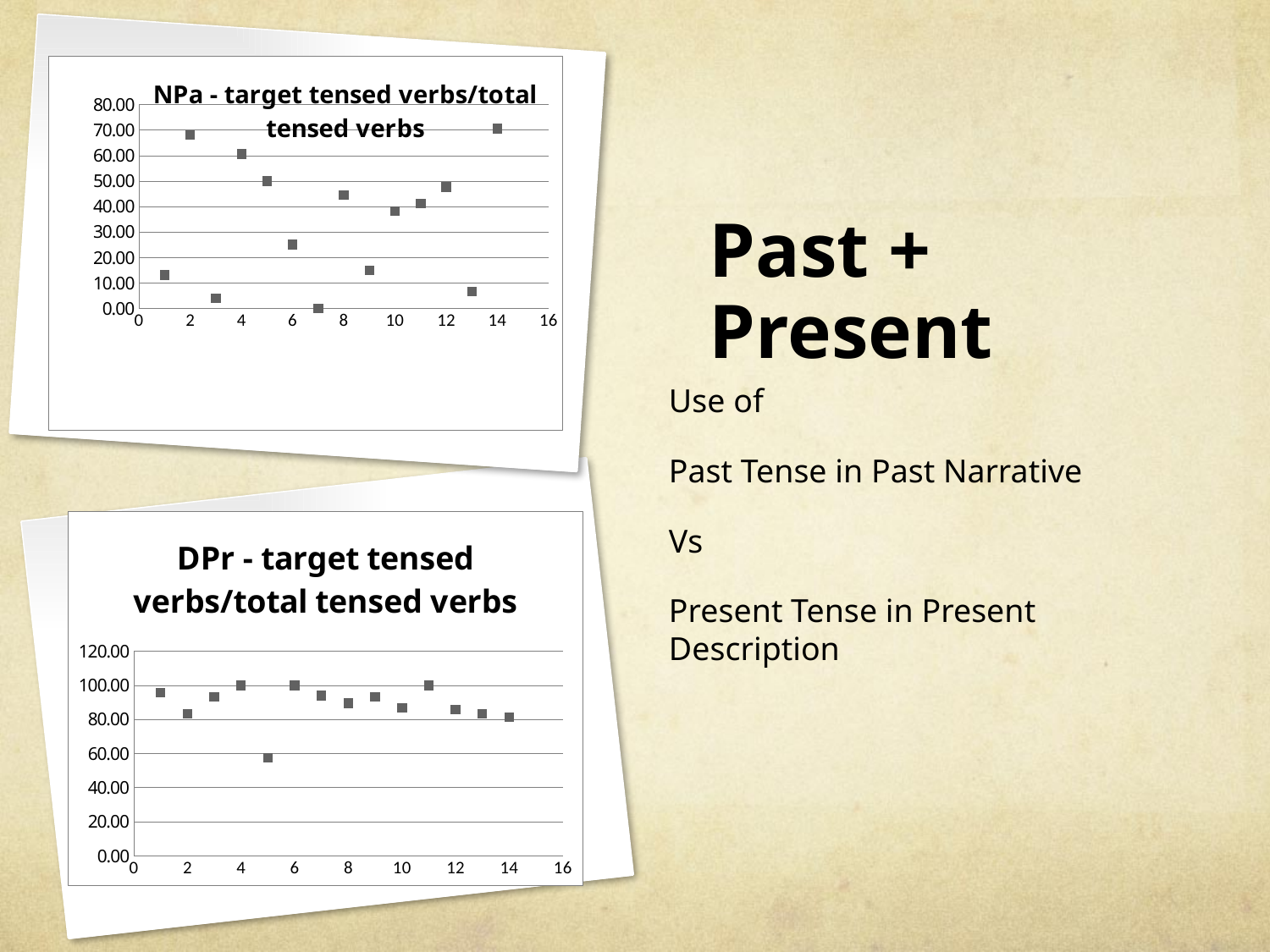
In the bottom chart 'DPr - target tensed verbs/total tensed verbs', is the value at x = 4 greater or less than 80.00? greater How many data points are plotted in the bottom chart 'DPr - target tensed verbs/total tensed verbs'? 14 In the top chart 'NPa - target tensed verbs/total tensed verbs', which has the larger value, the point at x = 2 or the point at x = 3? x = 2 In the top chart 'NPa - target tensed verbs/total tensed verbs', is the value at x = 6 greater or less than 20.00? greater How many data points are plotted in the top chart 'NPa - target tensed verbs/total tensed verbs'? 14 In the bottom chart 'DPr - target tensed verbs/total tensed verbs', which has the larger value, the point at x = 4 or the point at x = 5? x = 4 In the top chart 'NPa - target tensed verbs/total tensed verbs', is the value at x = 2 greater or less than 60.00? greater In the bottom chart 'DPr - target tensed verbs/total tensed verbs', at which x value is the lowest point? 5 What kind of chart is the top chart titled 'NPa - target tensed verbs/total tensed verbs'? scatter chart What is the highest value shown on the y axis of the bottom chart 'DPr - target tensed verbs/total tensed verbs'? 120.00